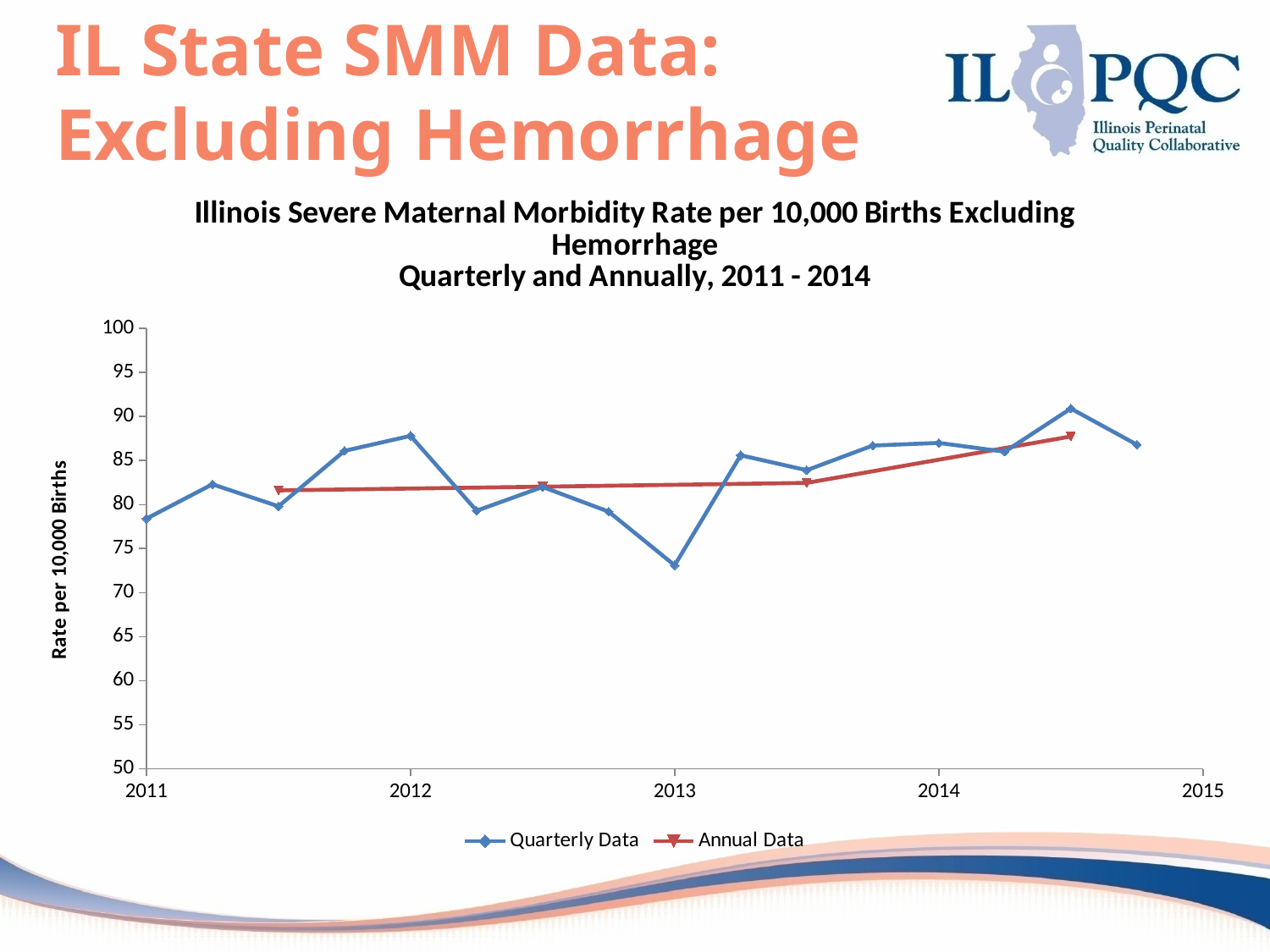
How many data points does the Annual Data series have? 4 What are the two series named in the legend? Quarterly Data and Annual Data Is the Annual Data value for 2011 greater or less than 85? less How many series does the legend list? 2 How many data points does the Quarterly Data series have? 16 Which is larger, the Annual Data value for 2014 or the Annual Data value for 2011? 2014 Is the lowest point of the Quarterly Data series greater or less than 75? less Is the Annual Data value for 2014 greater or less than 85? greater Does the Annual Data series rise or fall from 2011 to 2014? Rises In which year does the Annual Data series reach its highest value? 2014 What is the label on the vertical axis? Rate per 10,000 Births What kind of chart is shown on the slide? Line chart